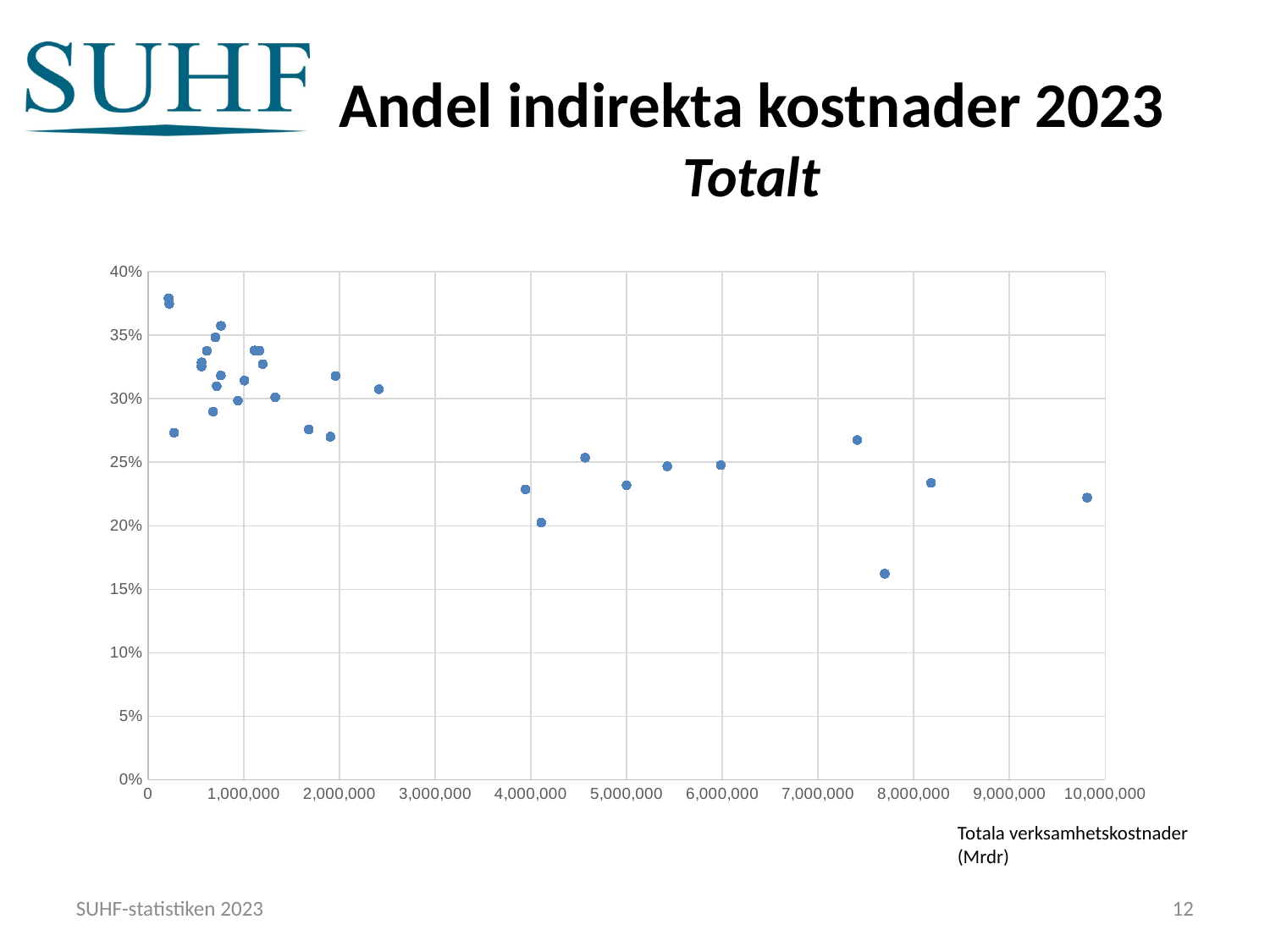
Which is higher: the point near 7,400,000 on the x axis or the point near 7,700,000 on the x axis? the point near 7,400,000 Is the value for the point near 2,400,000 on the x axis greater or less than 30%? greater Are the highest points on the chart (near the left edge) greater or less than 35%? greater What is the title of the chart on the slide? Andel indirekta kostnader 2023 Totalt Which is higher: the point near 1,000,000 on the x axis or the point near 6,000,000 on the x axis? the point near 1,000,000 Is the value for the rightmost point (near 10,000,000 on the x axis) greater or less than 25%? less What label is shown for the horizontal axis of the chart? Totala verksamhetskostnader (Mrdr) What kind of chart is shown on the slide? scatter chart Do the plotted values generally rise or fall as the total costs on the x axis increase? fall